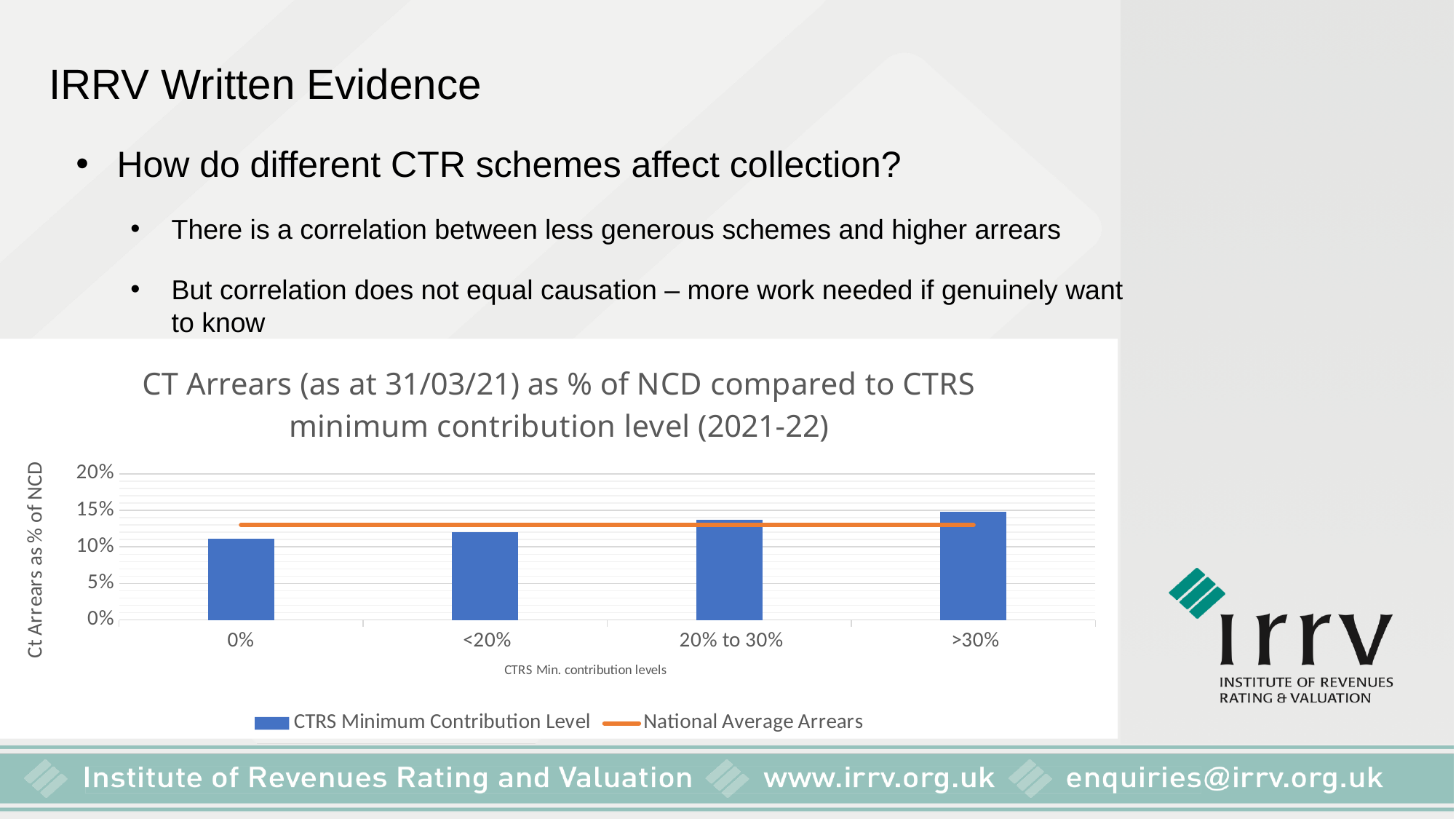
What kind of chart is shown on the slide? combination bar and line chart What does the orange line in the chart represent according to the legend? National Average Arrears Which CTRS minimum contribution level category has the highest CT arrears as % of NCD? >30% Which is larger, the value for >30% or the value for 0%? >30% Is the value for the 0% category greater or less than 10%? greater Do the bar values rise or fall moving from the 0% category to the >30% category? rise What is the title of the chart? CT Arrears (as at 31/03/21) as % of NCD compared to CTRS minimum contribution level (2021-22) How many series does the legend list? 2 How many CTRS minimum contribution level categories are shown on the x axis? 4 Which CTRS minimum contribution level category has the lowest CT arrears as % of NCD? 0% Is the value for the 20% to 30% category greater or less than 10%? greater Is the value for the <20% category greater or less than 15%? less